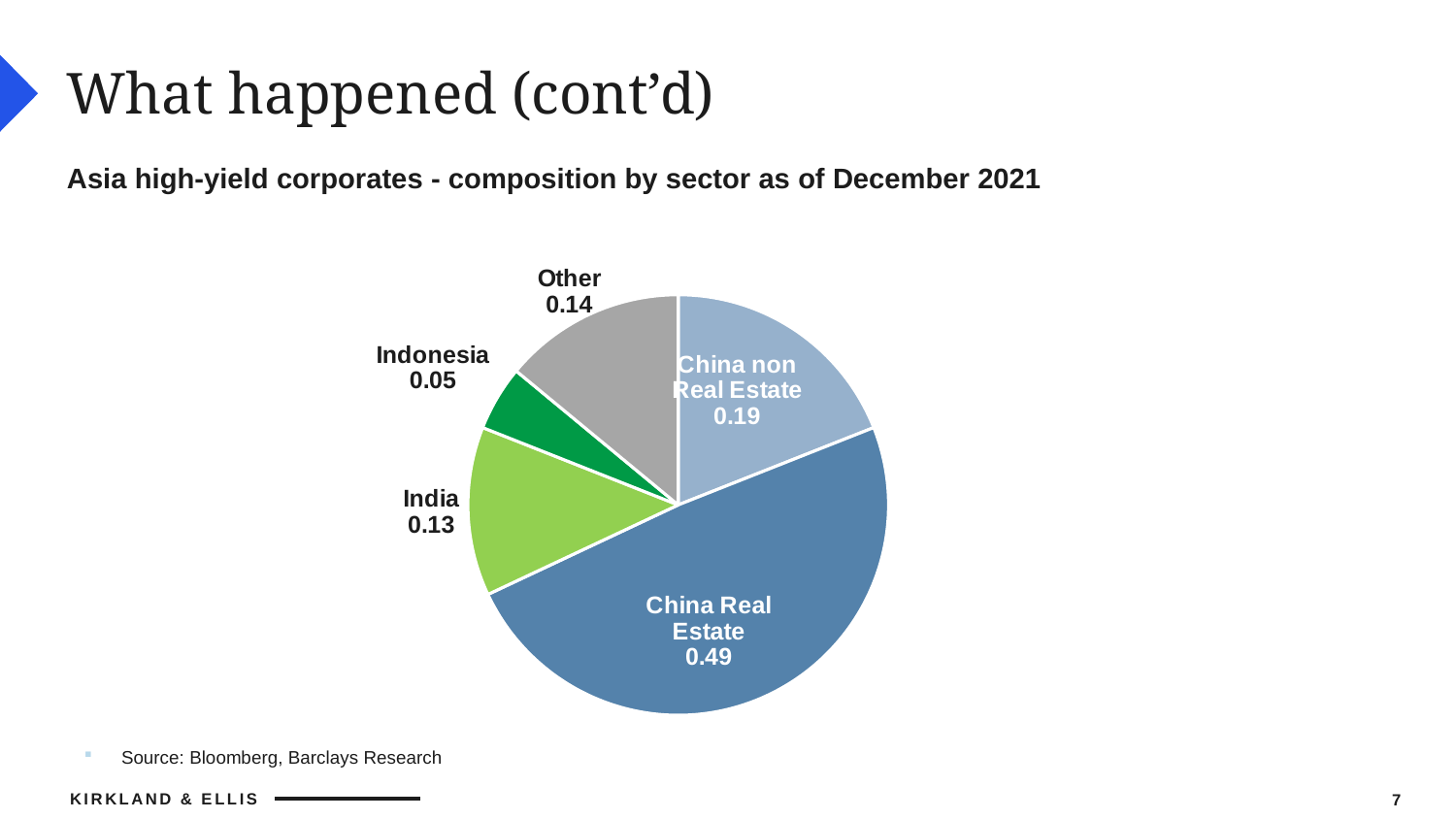
Which is larger, the value for India or the value for Other? Other How many slices does the pie chart have? 5 Which sector has the largest share of the pie? China Real Estate What is the value for China non Real Estate? 0.19 What kind of chart is shown on the slide? Pie chart What is the value for India? 0.13 What is the value for Indonesia? 0.05 What is the value for China Real Estate? 0.49 What is the difference between the values for China Real Estate and China non Real Estate? 0.30 What is the title of the chart? Asia high-yield corporates - composition by sector as of December 2021 Which sector has the smallest share of the pie? Indonesia What is the value for Other? 0.14